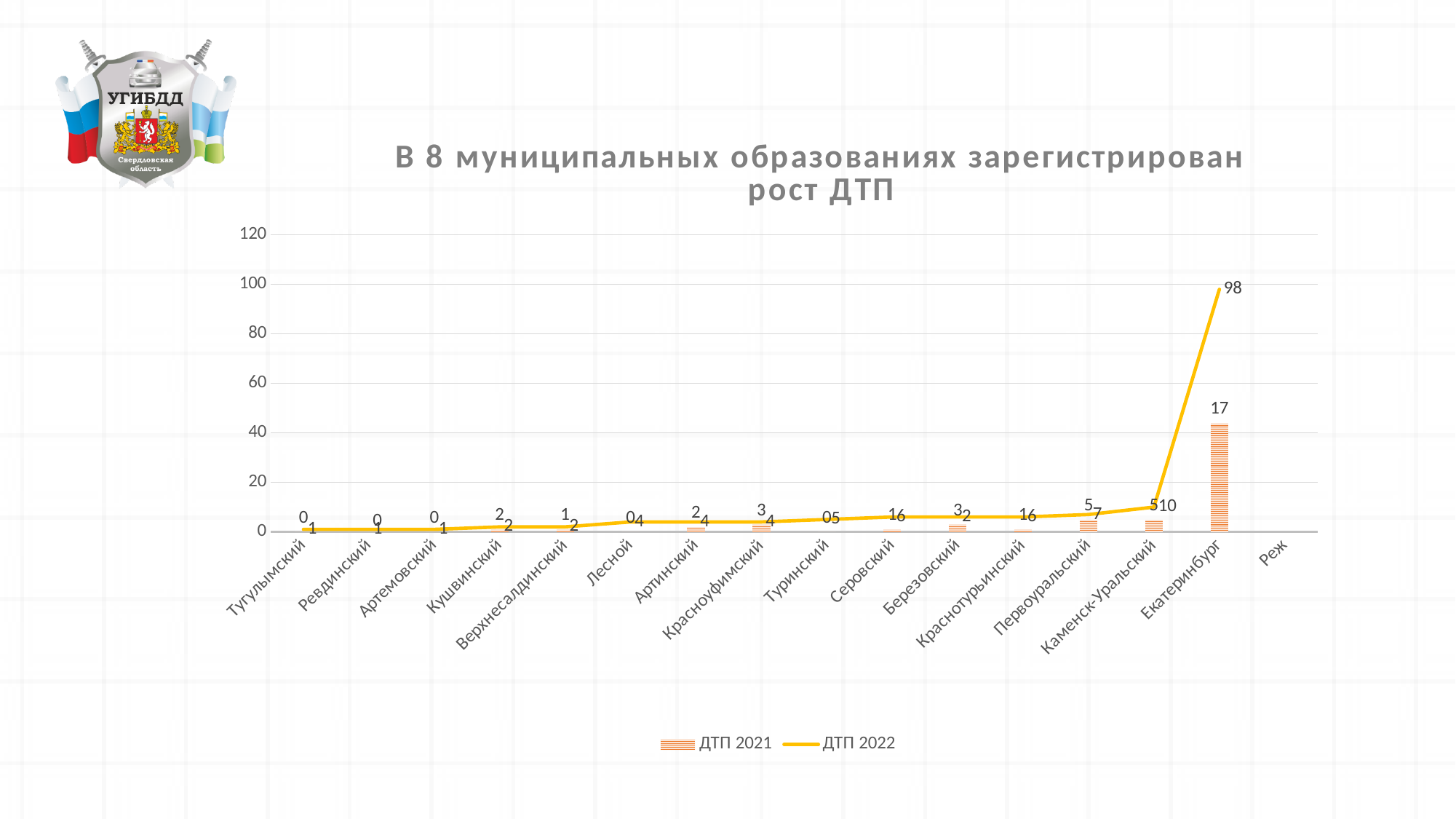
What is the title of the chart? В 8 муниципальных образованиях зарегистрирован рост ДТП Which has the larger ДТП 2022 value, Екатеринбург or Каменск-Уральский? Екатеринбург What is the ДТП 2022 value for Екатеринбург? 98 What are the two series named in the legend? ДТП 2021 and ДТП 2022 How many series does the legend list? 2 Is the ДТП 2022 value for Екатеринбург greater or less than 80? greater Which municipality has the highest ДТП 2022 value? Екатеринбург How many municipalities are listed along the x axis? 16 What kind of chart is shown on the slide? A combined bar and line chart What is the ДТП 2022 value for Каменск-Уральский? 10